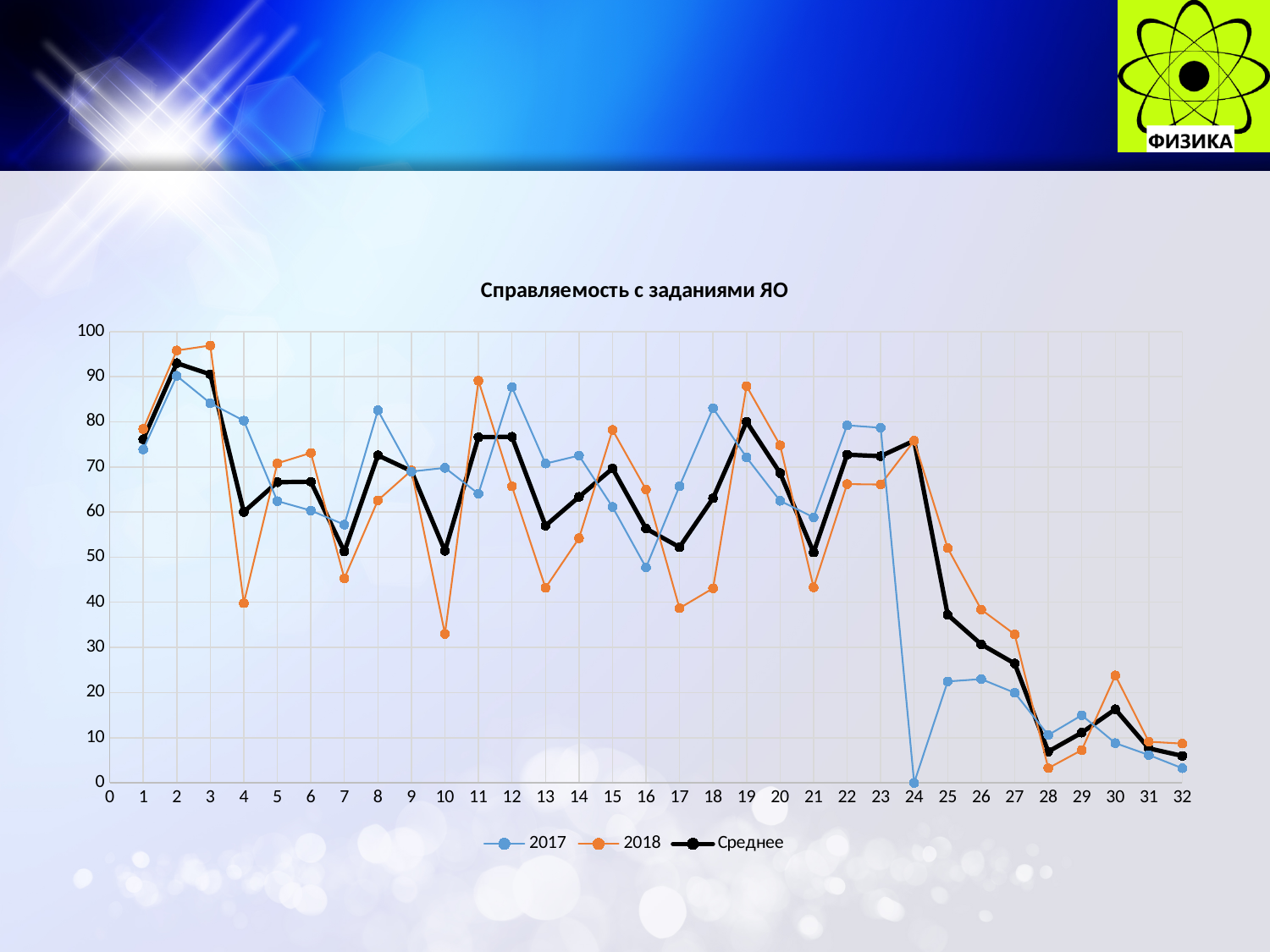
Is the value for Среднее at task 28 greater or less than 10? less How many task numbers have plotted points on the chart? 32 What is the title of the chart? Справляемость с заданиями ЯО Is the value for 2018 at task 10 greater or less than 40? less Is the value for 2017 at task 12 greater or less than 80? greater At task 8, which series has the larger value, 2017 or 2018? 2017 At which task does the 2018 series reach its lowest value? 28 At which task does the 2017 series reach its lowest value? 24 What kind of chart is shown on the slide? line chart Which series is drawn with the black line? Среднее How many series does the legend list? 3